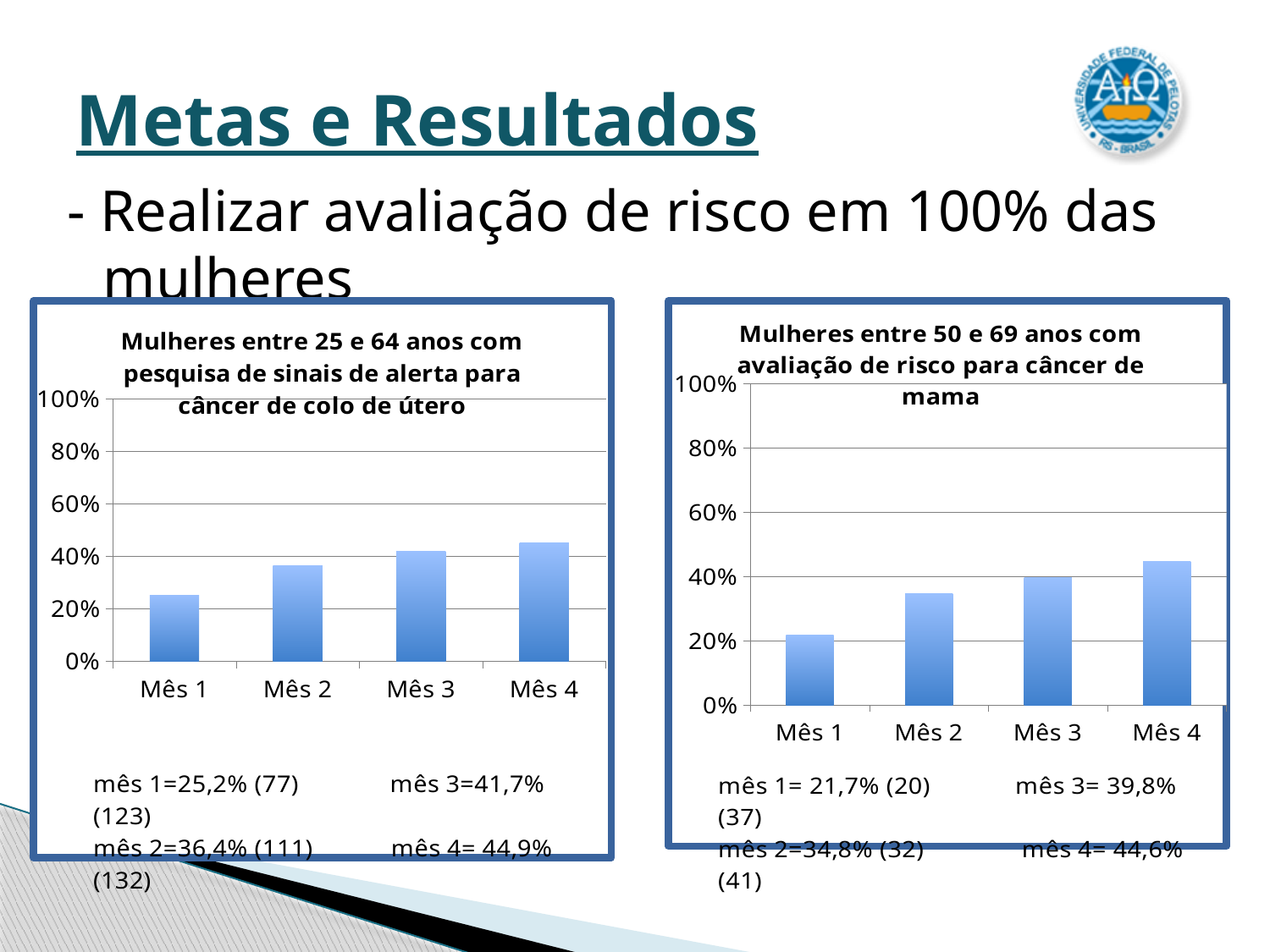
How many months (categories) are shown in the right chart (câncer de mama)? 4 In the right chart (câncer de mama), what is the value for Mês 2? 34,8% In the right chart (câncer de mama), is the value for Mês 1 greater or less than 40%? less In the right chart (câncer de mama), what is the value for Mês 3? 39,8% What type of chart is the left chart, 'Mulheres entre 25 e 64 anos com pesquisa de sinais de alerta para câncer de colo de útero'? Bar chart In the left chart (câncer de colo de útero), do the values rise or fall from Mês 1 to Mês 4? Rise In the left chart (câncer de colo de útero), which month has the lowest value? Mês 1 In the left chart (câncer de colo de útero), what is the value for Mês 1? 25,2% In the left chart (câncer de colo de útero), what is the value for Mês 4? 44,9% In the left chart (câncer de colo de útero), what is the difference between the values for Mês 4 and Mês 1? 19,7 percentage points In the left chart (câncer de colo de útero), which month has the highest value? Mês 4 In the right chart (câncer de mama), which is larger, the value for Mês 1 or Mês 4? Mês 4